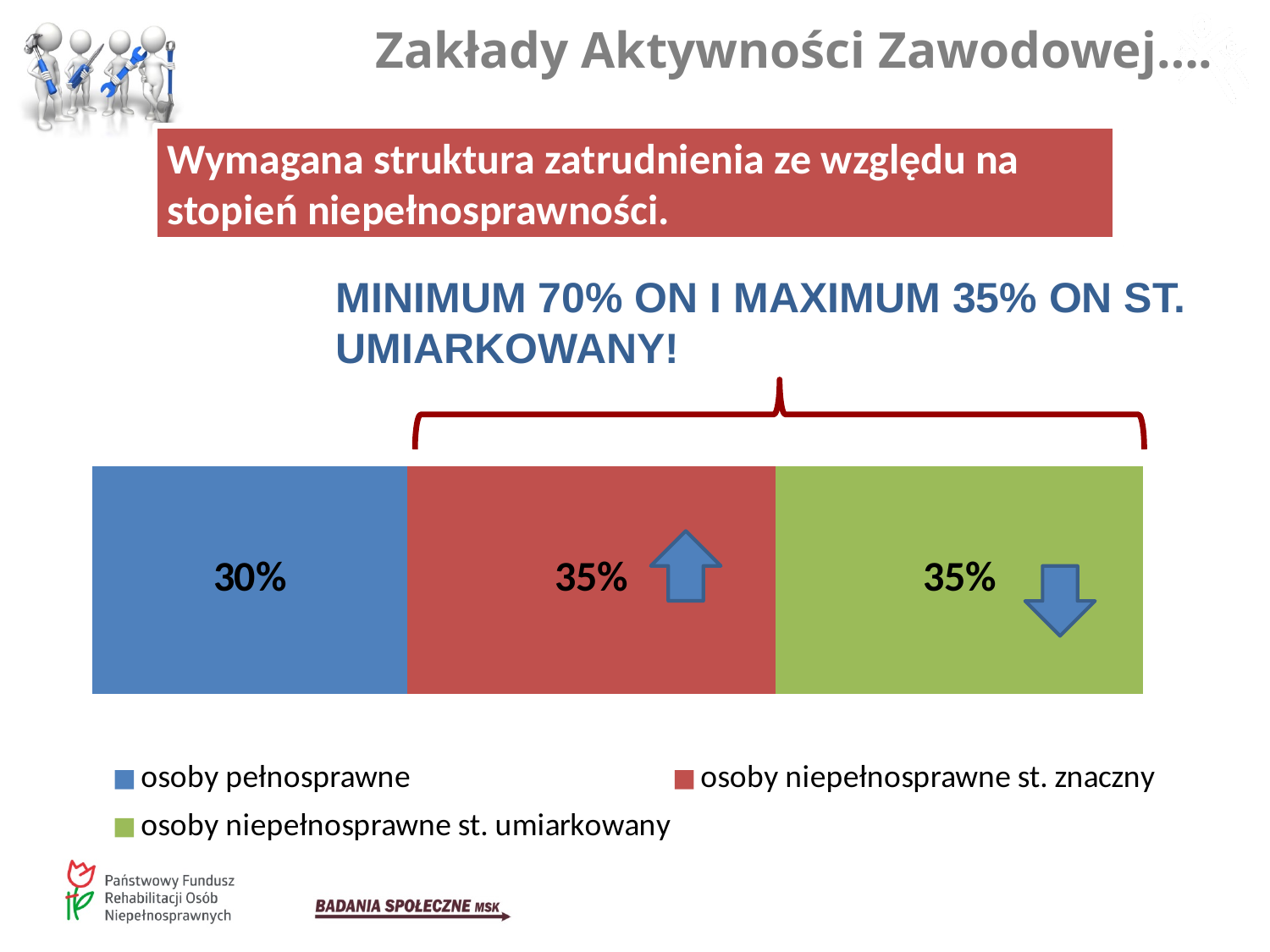
What value is shown for "osoby niepełnosprawne st. znaczny"? 35% What is the difference between the value for "osoby niepełnosprawne st. znaczny" and the value for "osoby pełnosprawne"? 5% What value is shown for "osoby pełnosprawne"? 30% What kind of chart is shown on the slide? stacked bar chart What is the total of all segments in the stacked bar? 100% Which segment of the bar has the lowest value? osoby pełnosprawne What value is shown for "osoby niepełnosprawne st. umiarkowany"? 35% Which colour represents "osoby pełnosprawne" in the chart? blue How many series does the legend list? 3 Which colour represents "osoby niepełnosprawne st. znaczny" in the chart? red What is the combined value of the two "osoby niepełnosprawne" segments (st. znaczny and st. umiarkowany)? 70% Which is larger: the value for "osoby pełnosprawne" or the value for "osoby niepełnosprawne st. umiarkowany"? osoby niepełnosprawne st. umiarkowany